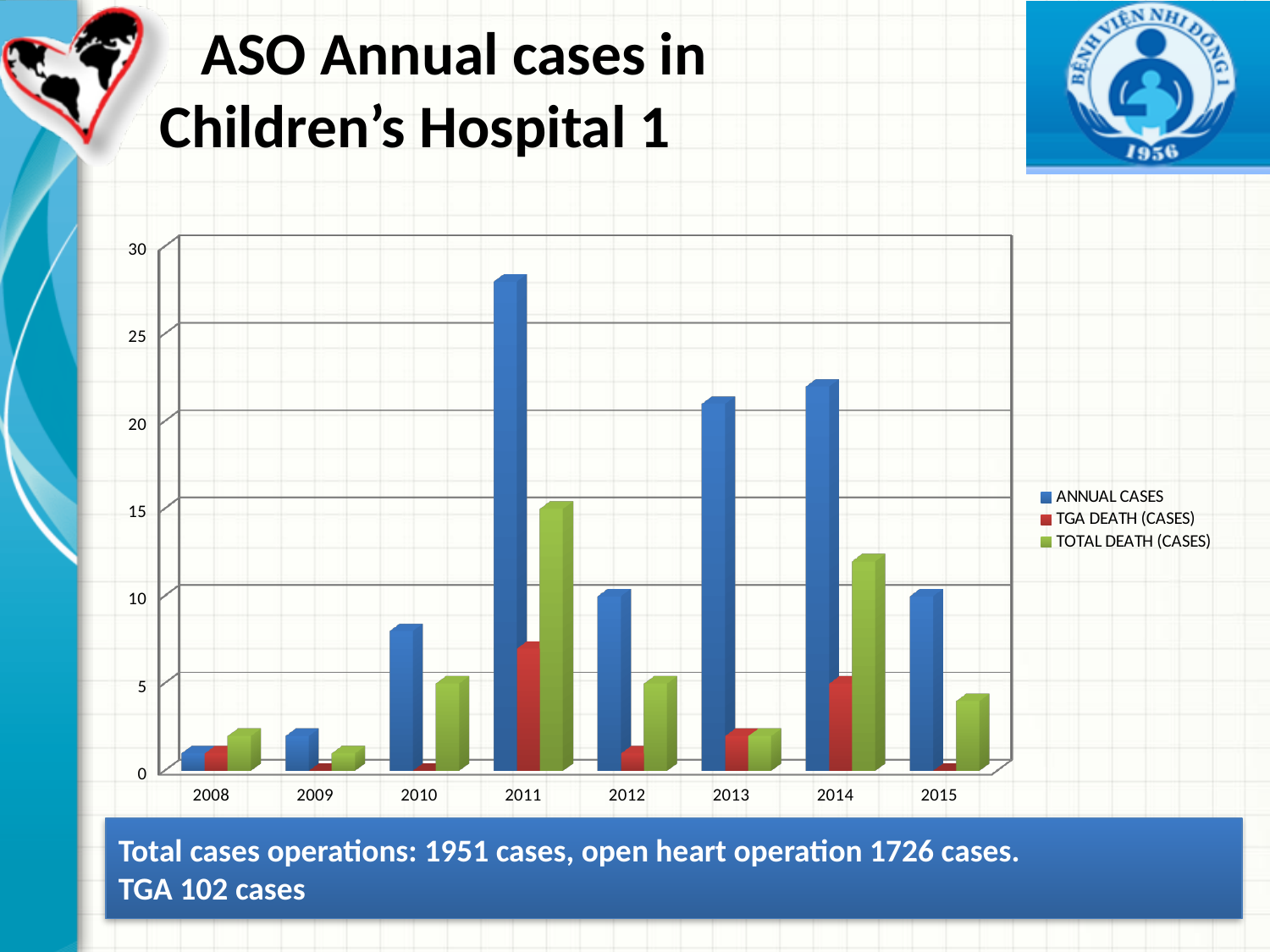
Which year has the highest TOTAL DEATH (CASES)? 2011 Which year has the lowest number of ANNUAL CASES? 2008 What are the three series listed in the legend? ANNUAL CASES, TGA DEATH (CASES), TOTAL DEATH (CASES) Is the value for TOTAL DEATH (CASES) in 2014 greater or less than 10? greater Which year has the highest number of ANNUAL CASES? 2011 How many series does the legend list? 3 How many years are shown on the x axis? 8 Is the value for ANNUAL CASES in 2011 greater or less than 25? greater Is the value for TGA DEATH (CASES) in 2011 greater or less than 5? greater Which year has more ANNUAL CASES, 2013 or 2010? 2013 What kind of chart is shown on the slide? bar chart